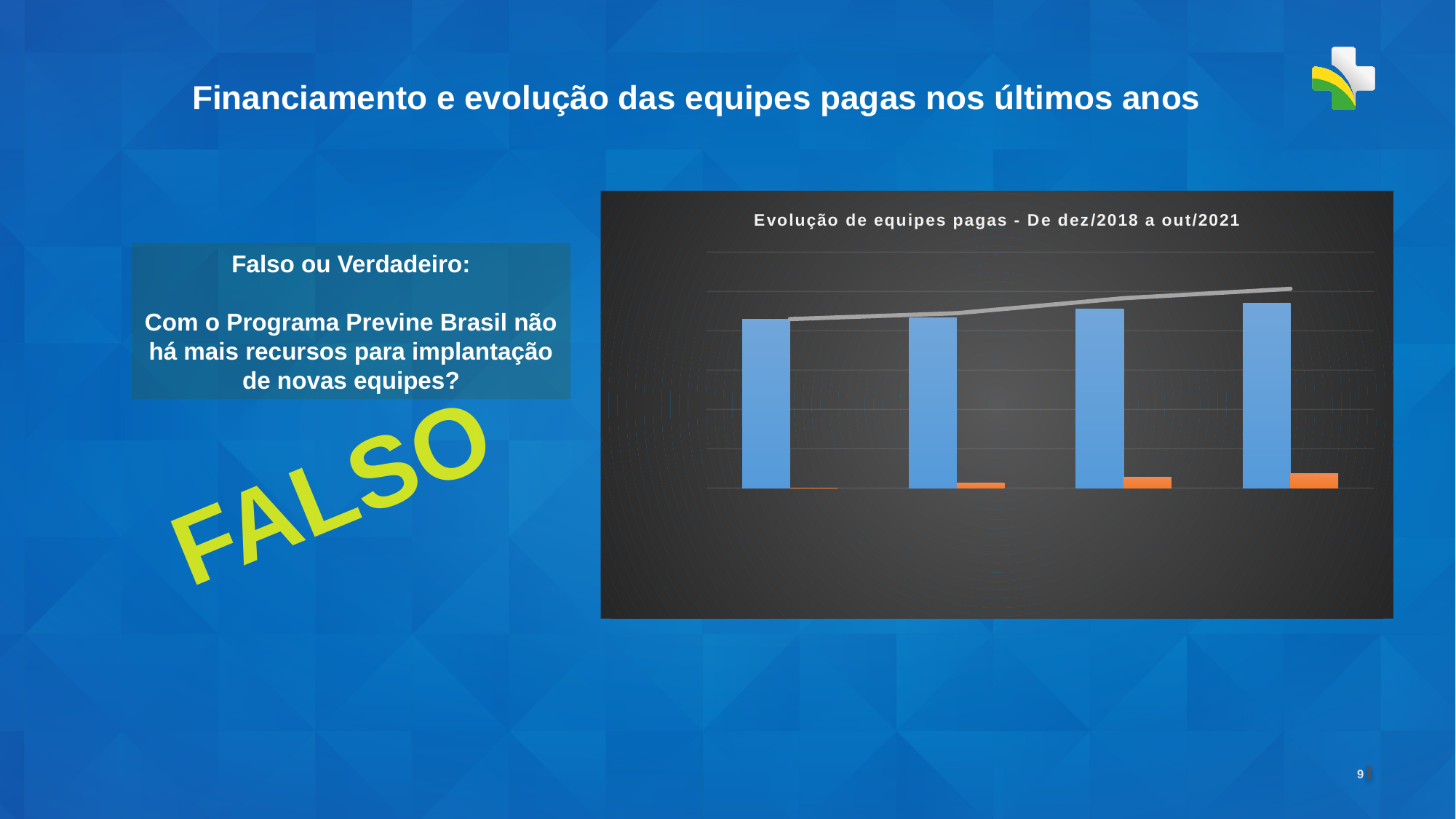
Which group of bars, counting from the left, has the shortest blue bar? the first (leftmost) Does the grey line in the chart rise or fall from left to right? rise How many groups of bars are plotted in the chart? 4 In the leftmost group of bars, which is taller: the blue bar or the orange bar? the blue bar Which group of bars, counting from the left, has the shortest orange bar? the first (leftmost) Do the orange bars rise or fall from left to right across the chart? rise What kind of chart is shown on the slide? combination bar and line chart Do the blue bars rise or fall from left to right across the chart? rise What is the title of the chart on the slide? Evolução de equipes pagas - De dez/2018 a out/2021 Which group of bars, counting from the left, has the tallest blue bar? the fourth (rightmost) Which colour are the taller bars in each group of the chart? blue